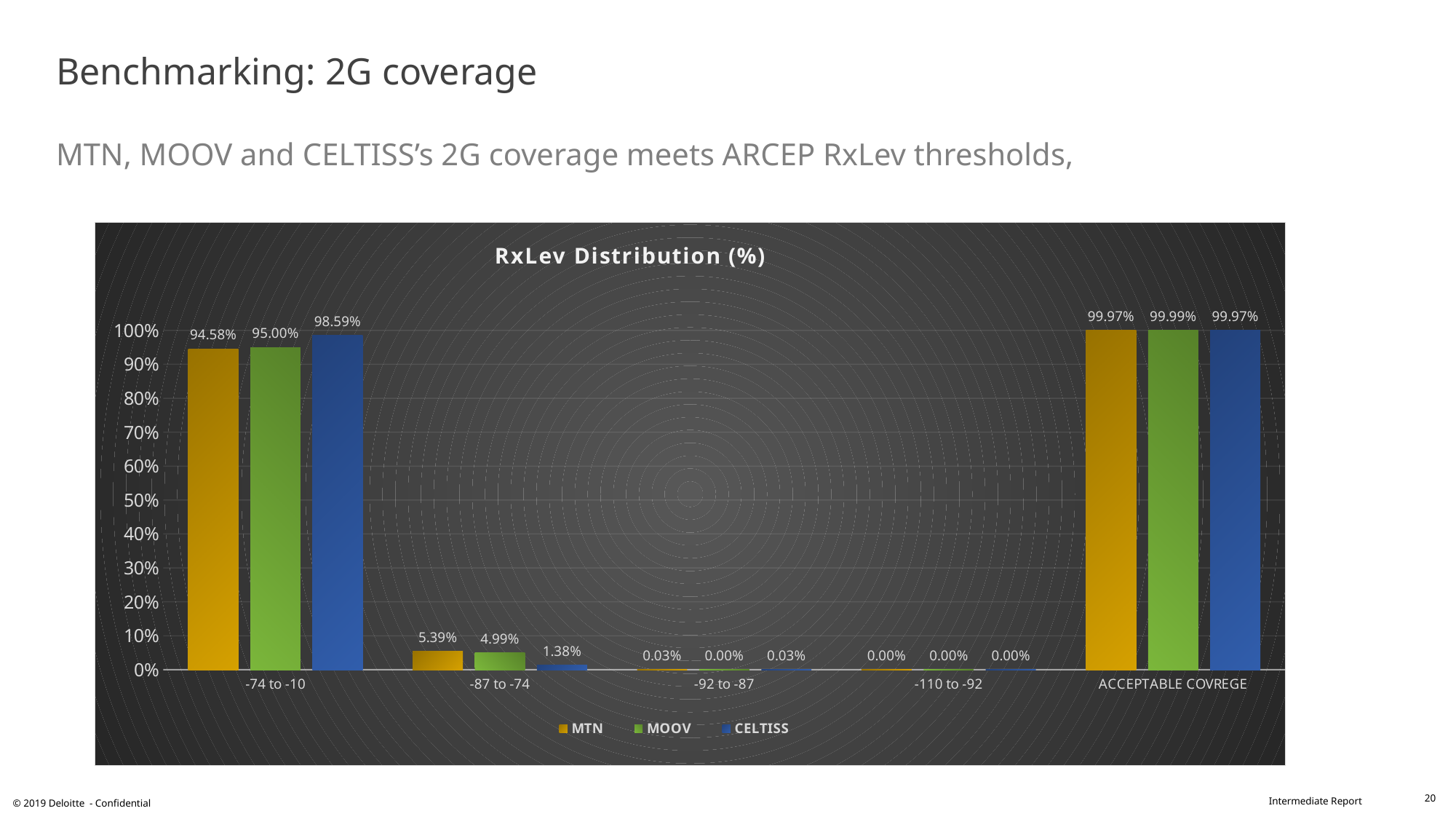
Which series has the highest value in the -74 to -10 category? CELTISS What is the value for CELTISS in the -74 to -10 category? 98.59% What is the title of the chart? RxLev Distribution (%) What is the difference between the MOOV and MTN values in the -74 to -10 category? 0.42% What is the value for MTN in the -87 to -74 category? 5.39% What kind of chart is shown on the slide? bar chart Which series has the lowest value in the -87 to -74 category? CELTISS What is the value for MOOV in the ACCEPTABLE COVREGE category? 99.99% Which is larger in the -87 to -74 category: MTN or MOOV? MTN How many series does the legend list? 3 Is the value for MTN in the -74 to -10 category greater or less than 90%? greater How many categories are shown on the x axis? 5